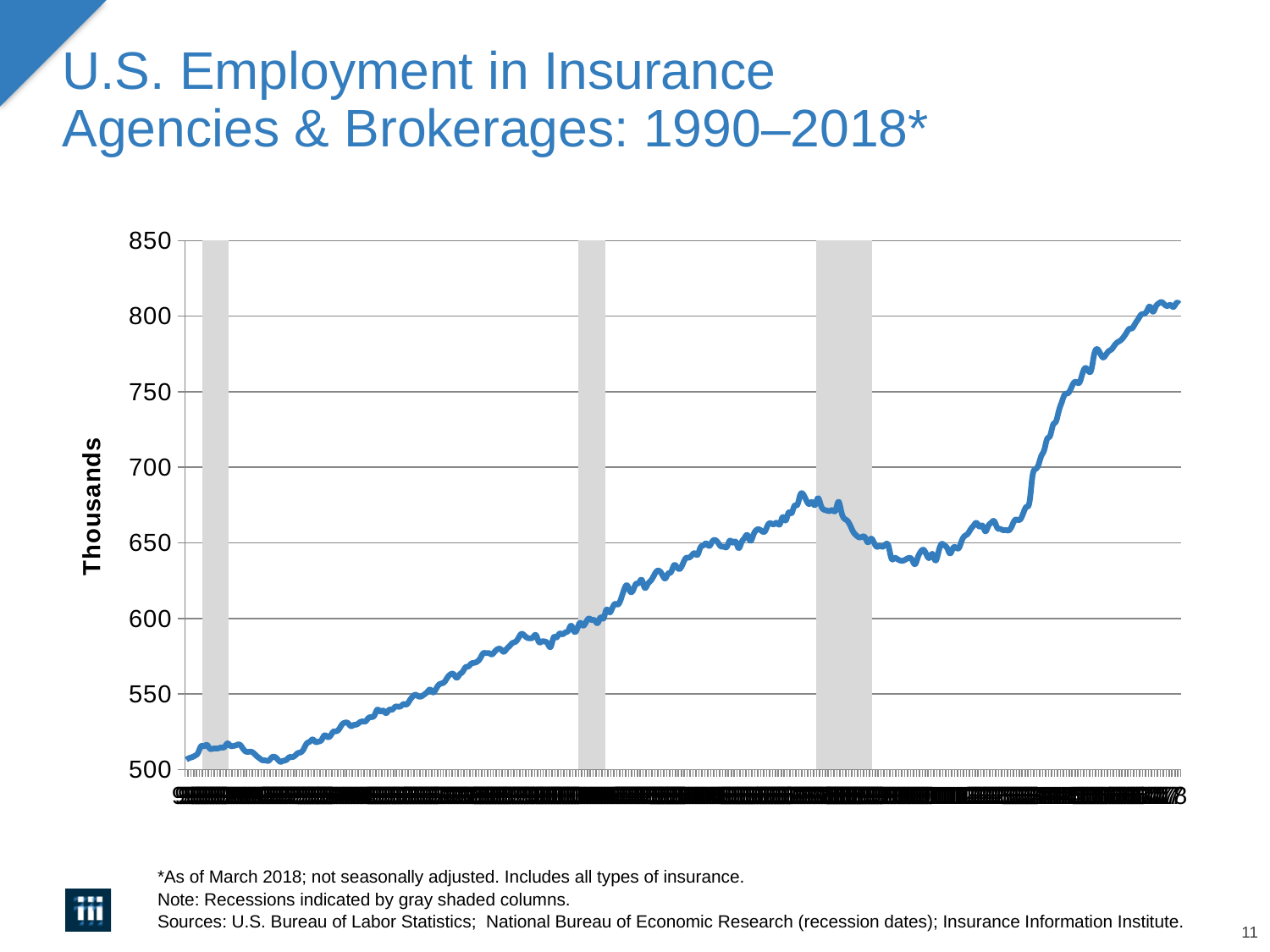
Is the value at the left end of the line (the earliest point) greater or less than 550? less Is the value at the right end of the line greater or less than 850? less What kind of chart is shown on the slide? line chart Overall, do the values rise or fall from the left of the x axis to the right? rise Is the value at the left end of the line (the earliest point) greater or less than 500? greater What is the label on the vertical axis? Thousands How many gray shaded recession columns are shown on the chart? 3